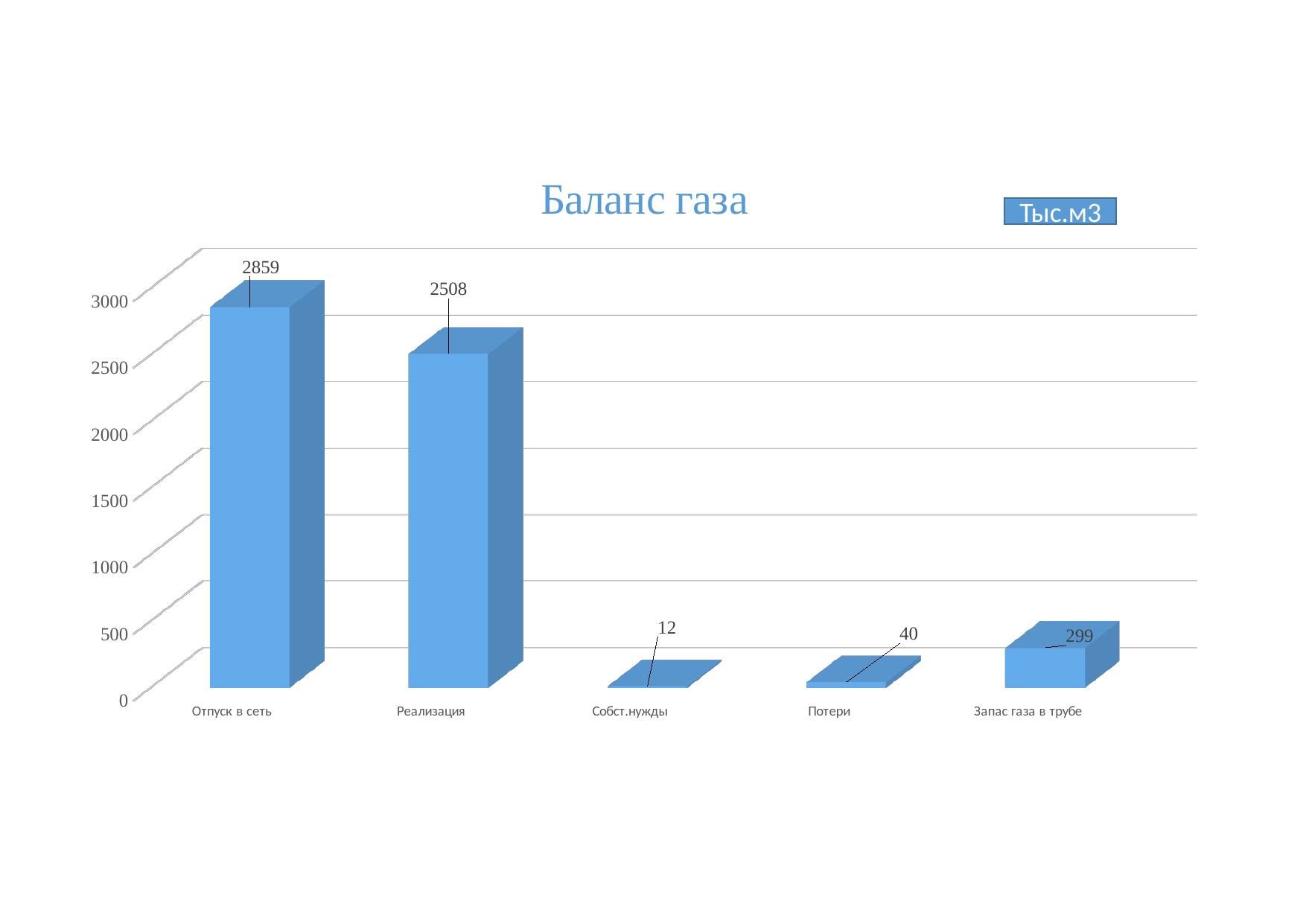
What kind of chart is shown on the slide? Bar chart Which category has the highest value? Отпуск в сеть Which is larger, Потери or Запас газа в трубе? Запас газа в трубе What is the value for Отпуск в сеть? 2859 What is the value for Запас газа в трубе? 299 How many categories are shown in the chart? 5 What is the difference between Отпуск в сеть and Реализация? 351 What is the title of the chart? Баланс газа What is the value for Реализация? 2508 What is the value for Потери? 40 Which category has the lowest value? Собст.нужды What is the value for Собст.нужды? 12